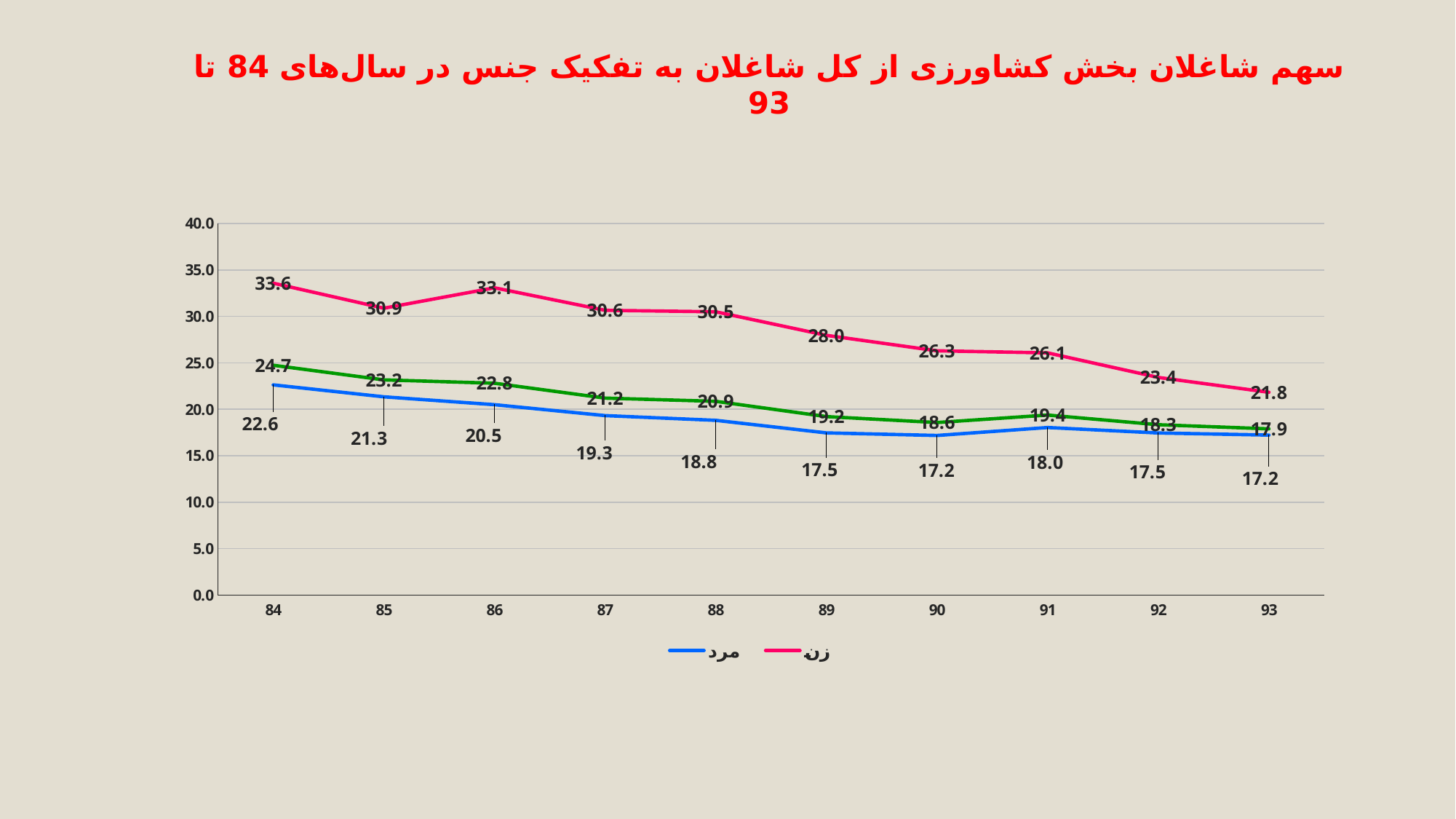
Which colour is used for the مرد series in the legend? blue What is the difference between the زن and مرد values in year 84? 11.0 In which year is the value for زن the lowest? 93 How many years are shown on the x axis? 10 What is the value for زن in year 84? 33.6 Does the value for زن generally rise or fall from year 84 to year 93? fall In which year is the value for مرد the highest? 84 Which series has the larger value in year 90, زن or مرد? زن What is the value for زن in year 89? 28.0 What is the value for مرد in year 93? 17.2 What kind of chart is shown on the slide? line chart How many series does the legend list? 2